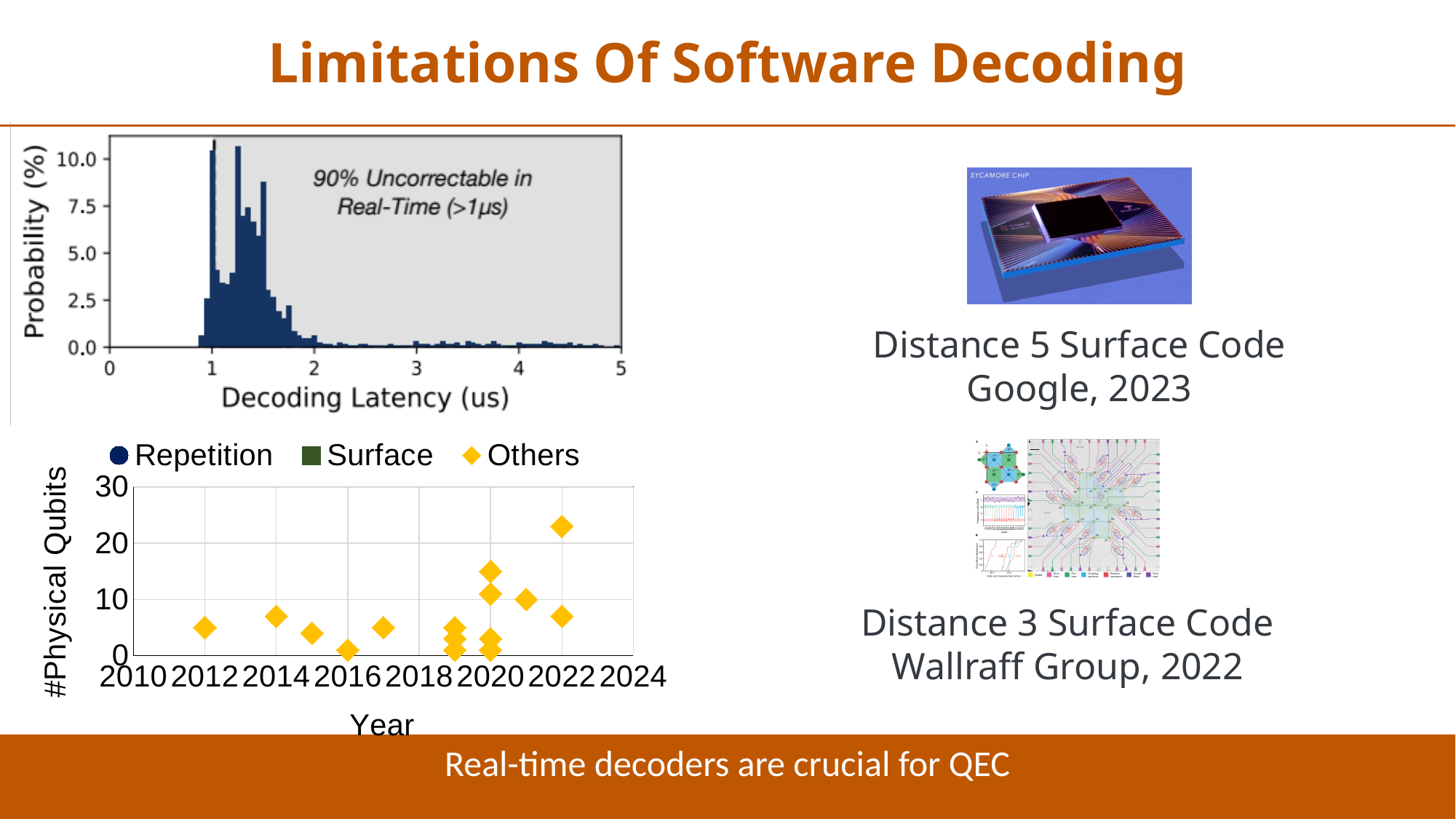
In the top-left chart, does the probability rise or fall as decoding latency increases from 1.5 us to 5 us? fall In the top-left chart, what is the label of the y axis? Probability (%) In the bottom-left chart, which year has the point with the highest number of physical qubits? 2022 In the bottom-left chart, is the highest point in 2020 greater or less than 10 physical qubits? greater In the bottom-left chart, which is larger: the highest point in 2022 or the highest point in 2020? 2022 How many series does the legend of the bottom-left chart list? 3 In the bottom-left chart, is the value for 2016 greater or less than 5 physical qubits? less In the bottom-left chart, is the highest point in 2022 greater or less than 20 physical qubits? greater What kind of chart is the bottom-left chart of #Physical Qubits versus Year? scatter chart In the top-left chart, what is the label of the x axis? Decoding Latency (us) What kind of chart is the top-left chart showing decoding latency? histogram (bar chart)